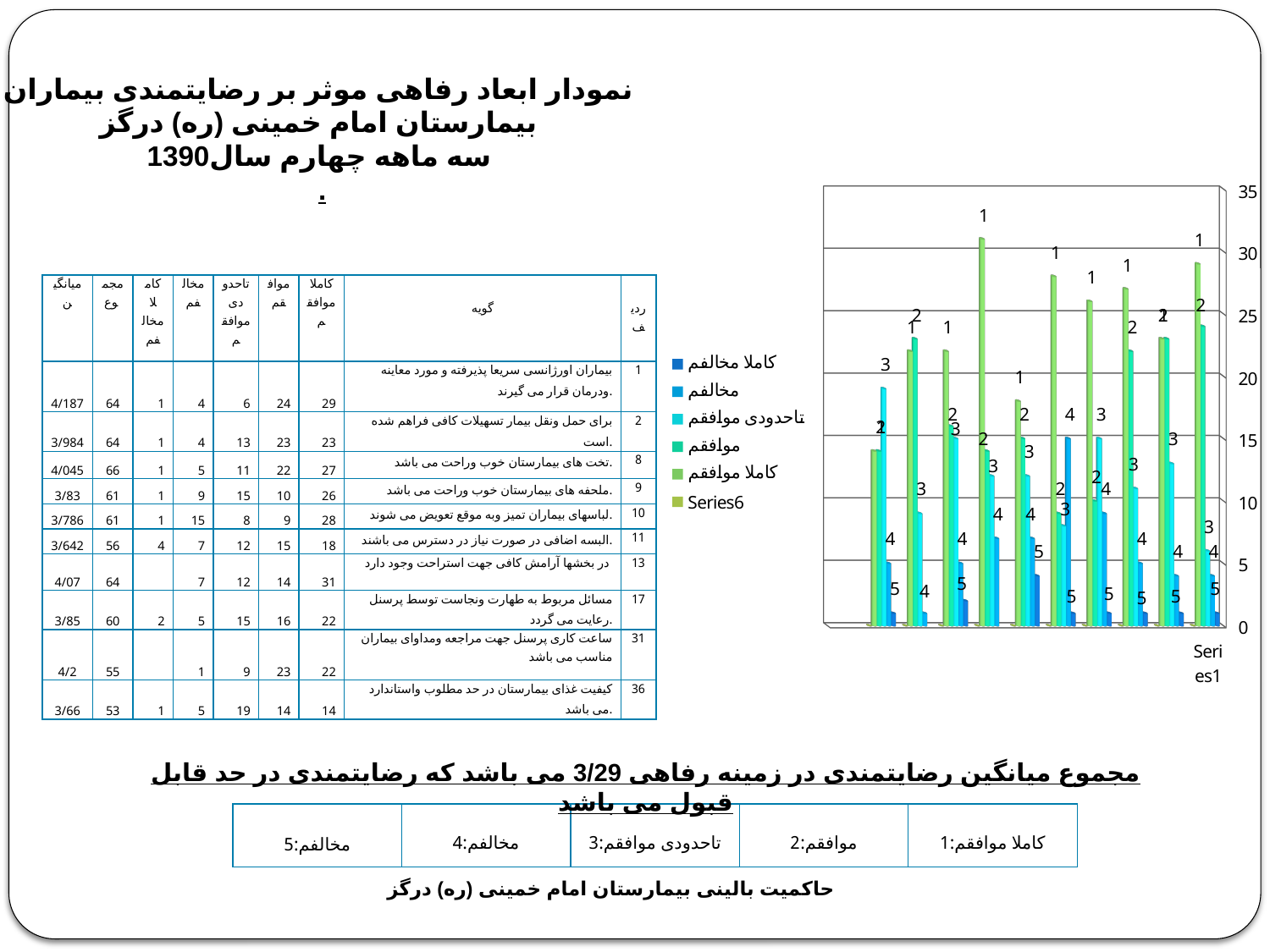
Is the tallest bar in the leftmost cluster greater or less than 20? greater Is the tallest bar on the chart greater or less than 35? less What is the last entry listed in the chart legend? Series6 What kind of chart is shown on the slide? bar chart How many entries does the chart legend list? 6 Is the tallest bar on the chart greater or less than 25? greater What is the highest value shown on the chart's vertical axis? 35